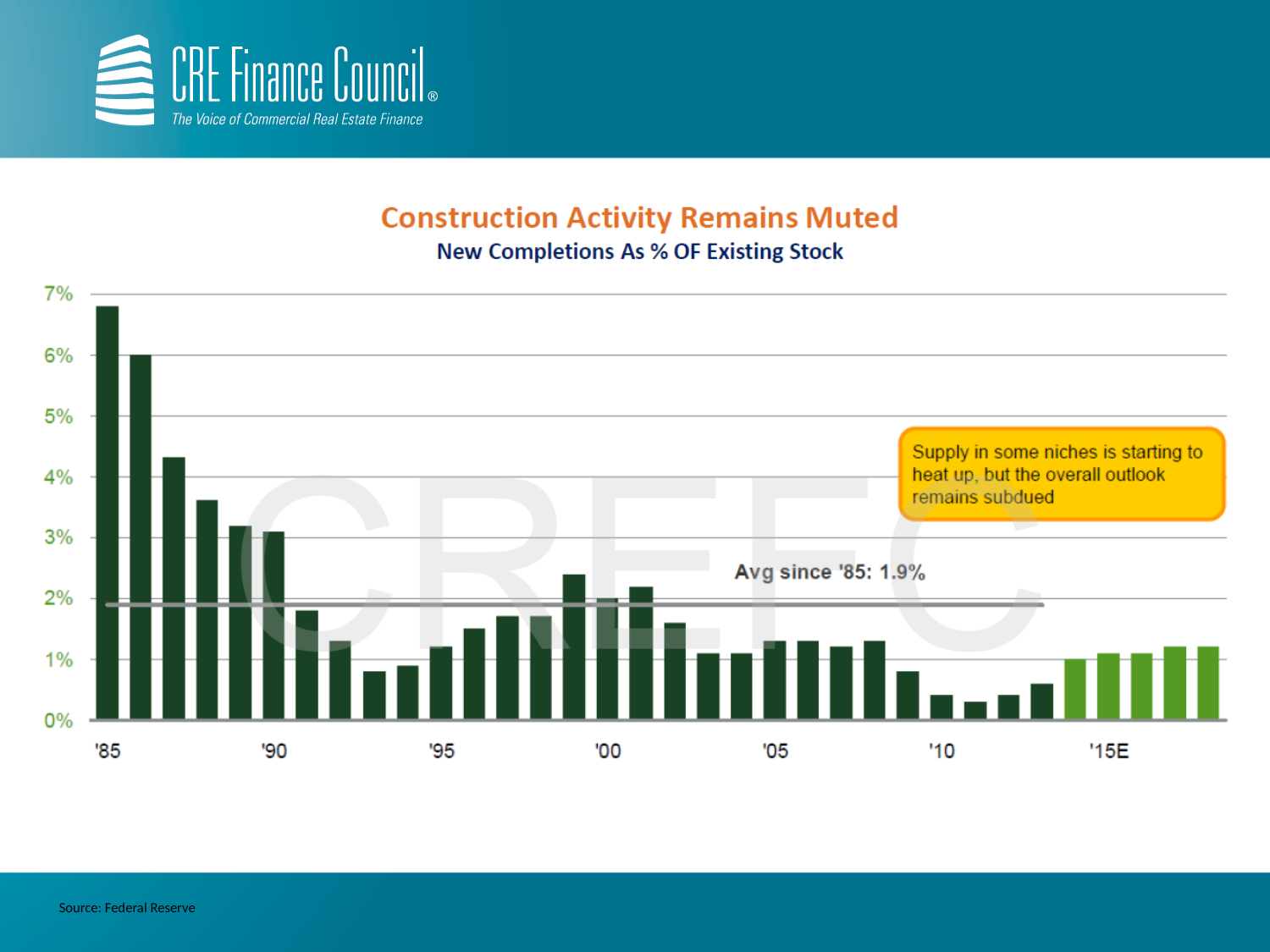
What is the subtitle of the chart, describing what is plotted? New Completions As % OF Existing Stock Is the value for '85 greater or less than 6%? greater Is the value for '05 greater or less than 1%? greater Which is larger, the value for '85 or the value for '90? '85 Overall, do the values rise or fall from '85 to '10? fall Which is larger, the value for '95 or the value for '10? '95 What is the average of new completions as % of existing stock since '85, as labelled on the chart? 1.9% What is the title of the chart? Construction Activity Remains Muted Which year has the highest value of new completions as % of existing stock? '85 What type of chart is shown on the slide? bar chart Is the value for '10 greater or less than 1%? less